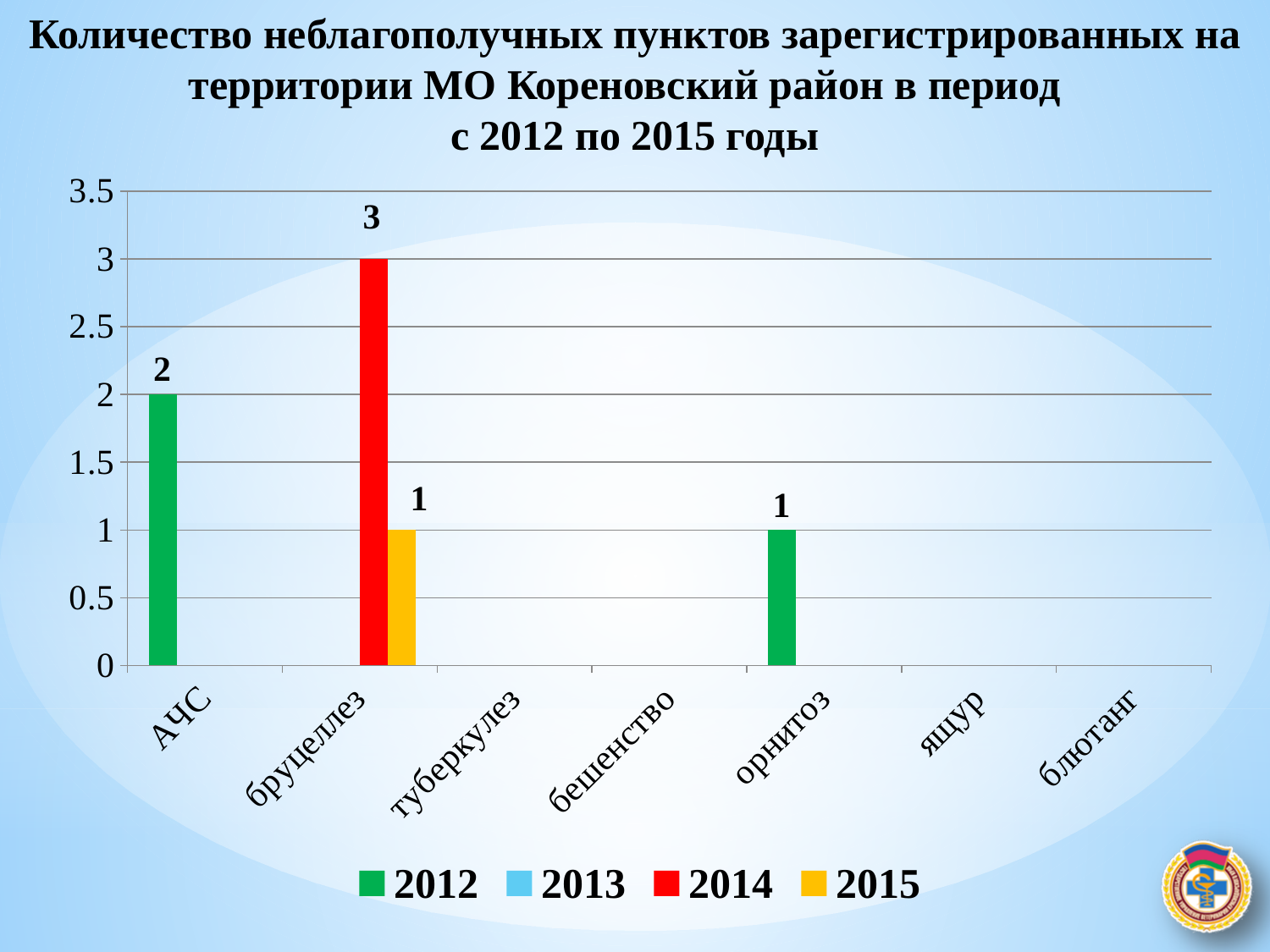
What is the value for орнитоз in 2012? 1 What is the value for бруцеллез in 2014? 3 Which years are listed in the legend? 2012, 2013, 2014, 2015 What is the value for бруцеллез in 2015? 1 What is the difference between the 2014 and 2015 values for бруцеллез? 2 What is the value for АЧС in 2012? 2 How many categories are shown on the x axis? 7 What type of chart is shown on the slide? bar chart What colour represents 2014 in the legend? red Which is larger: the 2012 value for АЧС or the 2012 value for орнитоз? АЧС How many series does the legend list? 4 Which category has the highest bar on the chart? бруцеллез